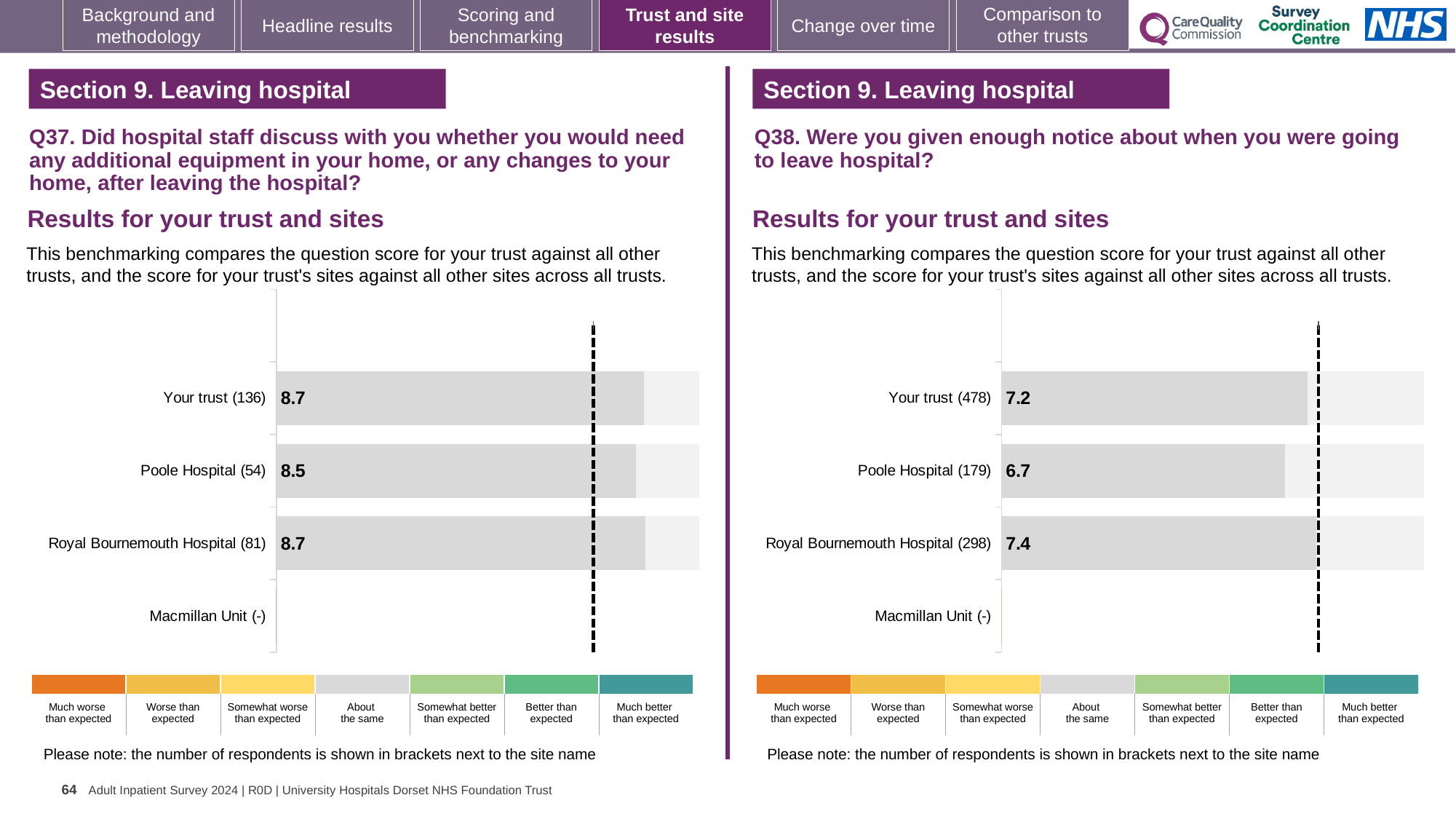
On the Q37 chart (left), which has the higher score, Poole Hospital or Royal Bournemouth Hospital? Royal Bournemouth Hospital On the Q38 chart (right), which site has the lowest score? Poole Hospital On the Q38 chart (right), what is the score for Poole Hospital? 6.7 On the Q38 chart (right), what is the score for Royal Bournemouth Hospital? 7.4 On the Q37 chart (left), what is the score for Your trust? 8.7 On the Q38 chart (right), what is the difference between the scores for Royal Bournemouth Hospital and Poole Hospital? 0.7 What kind of chart is used on the Q37 chart (left)? Bar chart On the Q38 chart (right), how many respondents are shown for Your trust? 478 On the Q37 chart (left), how many site rows are listed, including Your trust? 4 On the Q37 chart (left), what is the difference between the scores for Your trust and Poole Hospital? 0.2 On the Q38 chart (right), which site has the highest score? Royal Bournemouth Hospital On the Q37 chart (left), what is the score for Poole Hospital? 8.5